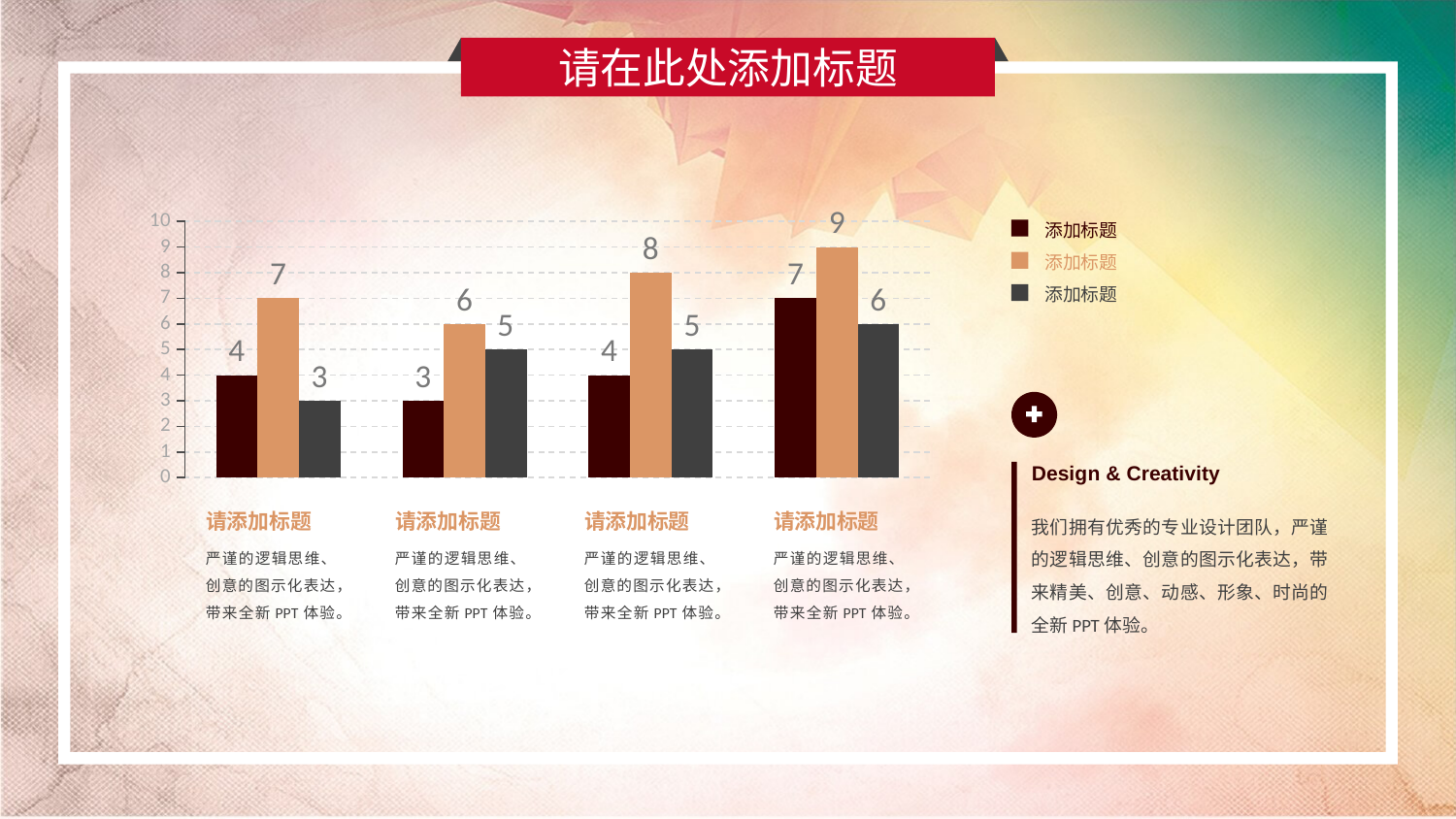
Is the value of the orange bar in the fourth group from the left greater or less than 8? greater What is the value of the orange bar in the first group from the left? 7 What is the value of the dark brown bar in the fourth group from the left? 7 Which is larger in the second group from the left: the orange bar or the dark grey bar? the orange bar What is the value of the dark grey bar in the second group from the left? 5 What kind of chart is shown on the slide? bar chart What is the difference between the orange bar and the dark brown bar in the third group from the left? 4 How many groups of bars does the chart have? 4 What is the maximum value shown on the vertical axis? 10 What is the highest value shown in the chart? 9 How many series does the chart's legend list? 3 What is the lowest value shown in the chart? 3